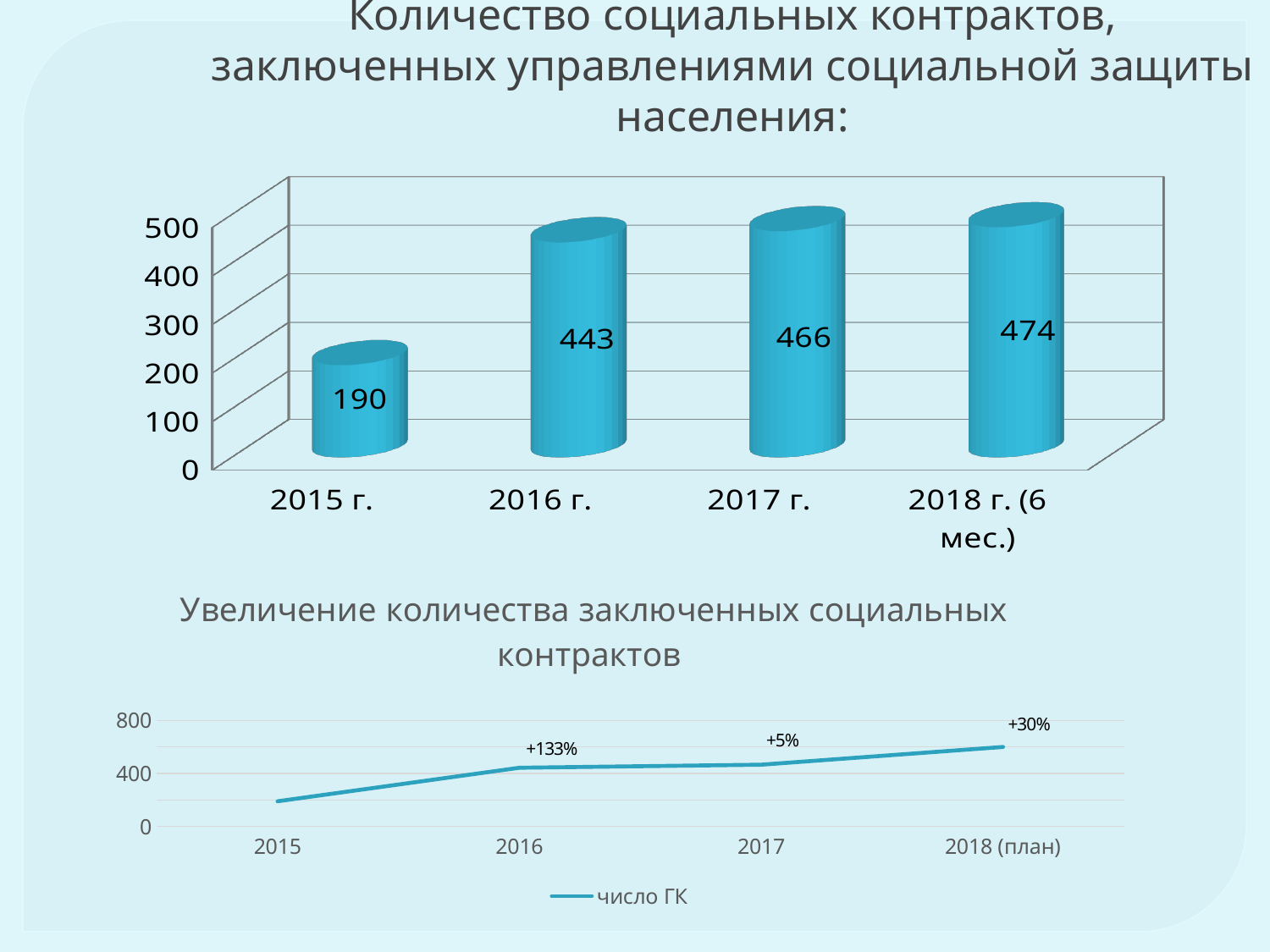
In the top chart, which is larger, the value for 2017 г. or the value for 2015 г.? 2017 г. In the top chart, how many social contracts were concluded in 2016 г.? 443 In the bottom chart, what percentage increase is labelled at 2016? +133% In the top chart, which category has the lowest value? 2015 г. In the top chart, what is the difference between the values for 2016 г. and 2015 г.? 253 In the bottom chart, is the value for 2018 (план) greater or less than 400? greater In the top chart, what is the value for 2018 г. (6 мес.)? 474 How many categories are shown in the top chart? 4 What kind of chart is the top chart? bar chart In the top chart, which category has the highest value? 2018 г. (6 мес.) In the top chart, what is the value for 2015 г.? 190 What series name does the legend of the bottom chart show? число ГК